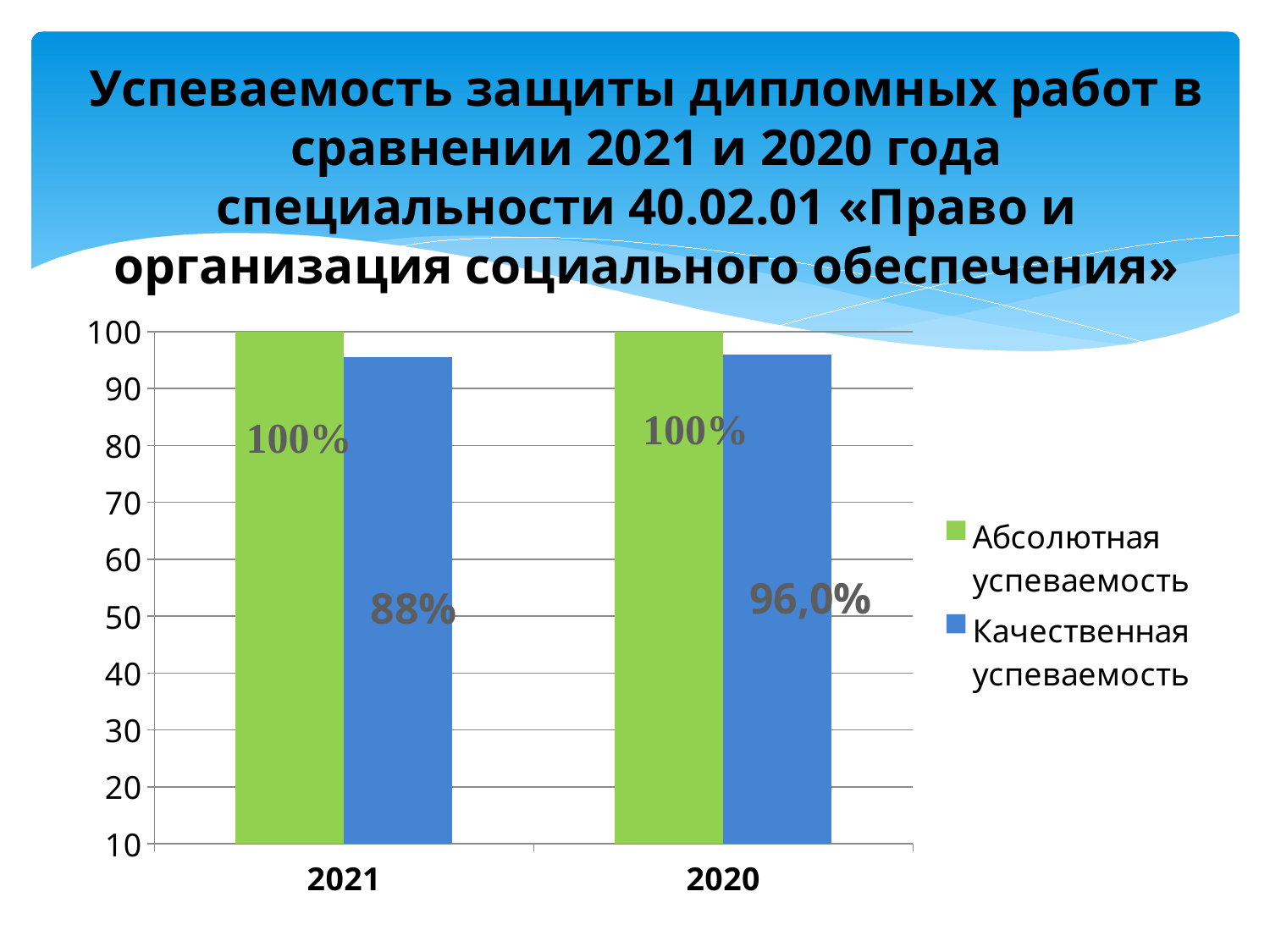
What is the value of Абсолютная успеваемость for 2020? 100% What kind of chart is shown on the slide? Bar chart What is the value of Качественная успеваемость for 2020? 96,0% Which is larger: Качественная успеваемость in 2020 or in 2021? 2020 In which year is Качественная успеваемость lower? 2021 Which colour represents Абсолютная успеваемость in the legend? Green How many series does the legend list? 2 Is the value of Абсолютная успеваемость for 2020 greater or less than 90? greater What is the value of Абсолютная успеваемость for 2021? 100% How many year categories are shown on the x axis? 2